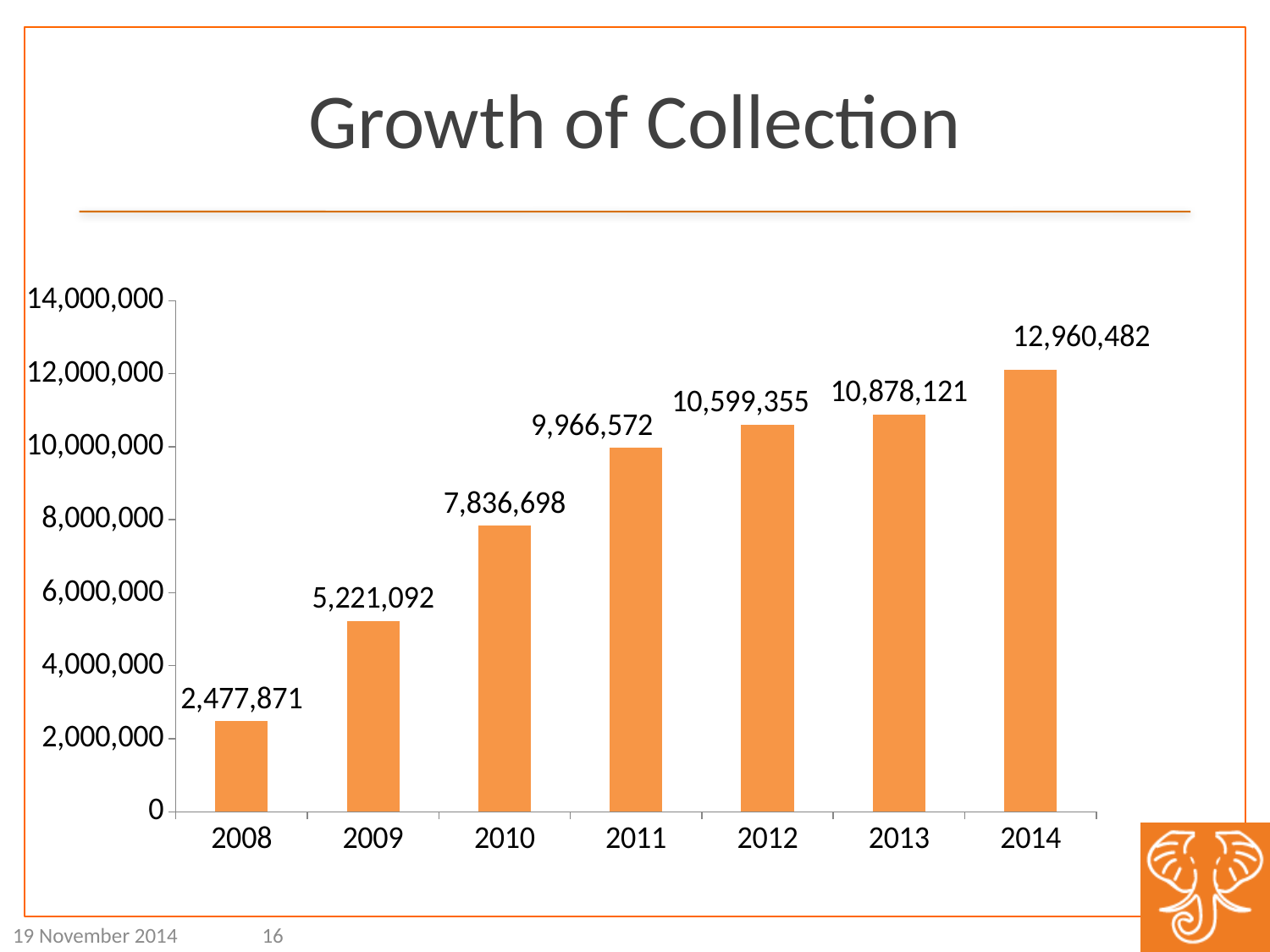
What kind of chart is shown on the slide? bar chart Which year has the highest value? 2014 What is the difference between the values for 2013 and 2012? 278,766 What is the value for 2012? 10,599,355 How many years are shown on the x axis? 7 Is the value for 2009 greater or less than 6,000,000? less Which is larger, the value for 2011 or the value for 2010? 2011 What is the value for 2008? 2,477,871 Which year has the lowest value? 2008 Do the values rise or fall from 2008 to 2014? rise What is the difference between the values for 2009 and 2008? 2,743,221 What is the value for 2010? 7,836,698